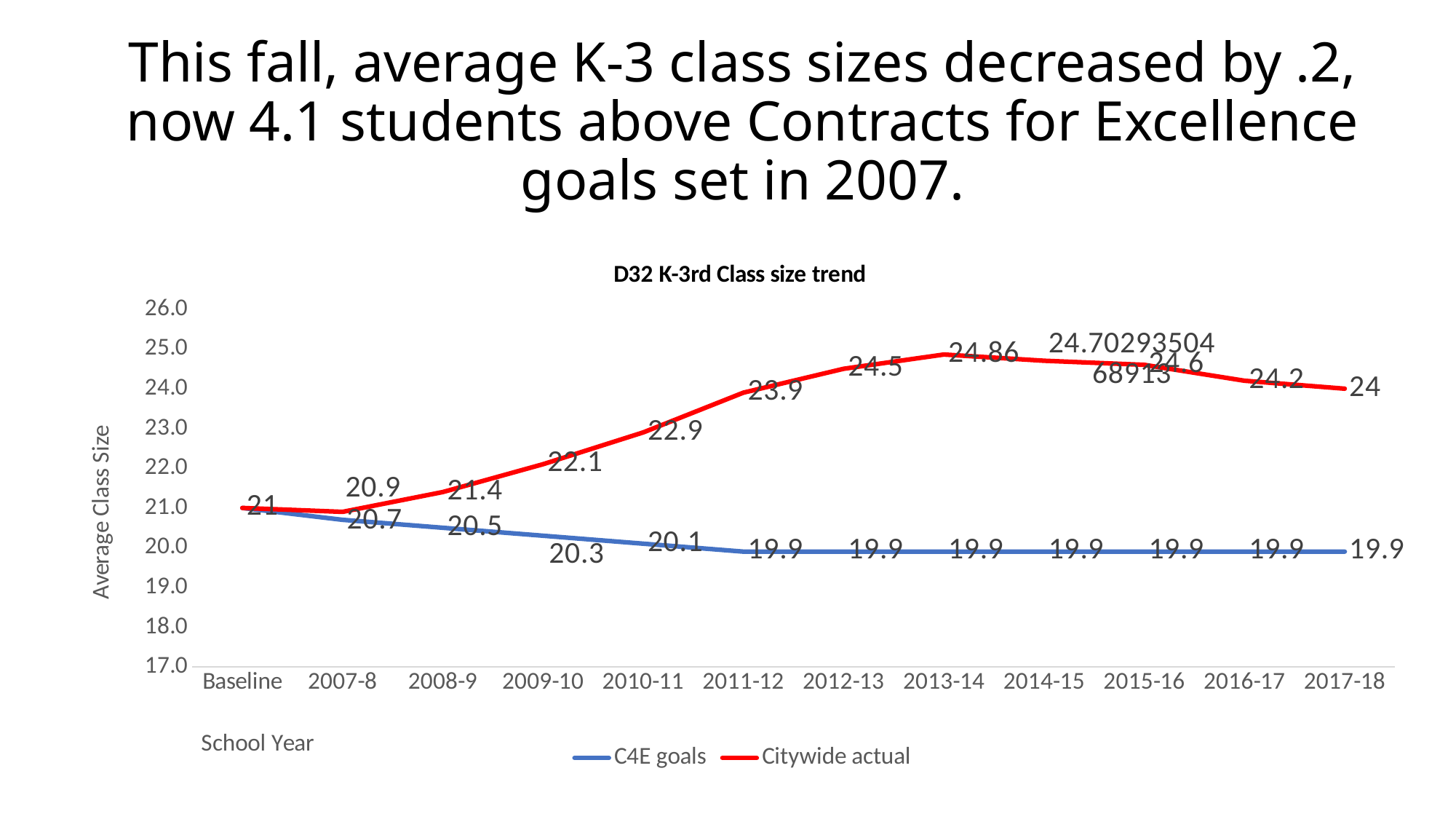
Which series has the larger value in 2012-13, C4E goals or Citywide actual? Citywide actual What is the difference between the Citywide actual and C4E goals values in 2017-18? 4.1 Does the C4E goals series rise or fall from Baseline to 2011-12? Fall How many school years (points) are plotted along the x axis? 12 In which school year is the Citywide actual value lowest? 2007-8 In which school year does the Citywide actual series reach its highest value? 2013-14 What is the Citywide actual value for 2013-14? 24.86 How many series does the legend list? 2 What is the C4E goals value for 2009-10? 20.3 What is the Citywide actual value for 2017-18? 24 What type of chart is shown on the slide? Line chart What is the title of the chart? D32 K-3rd Class size trend